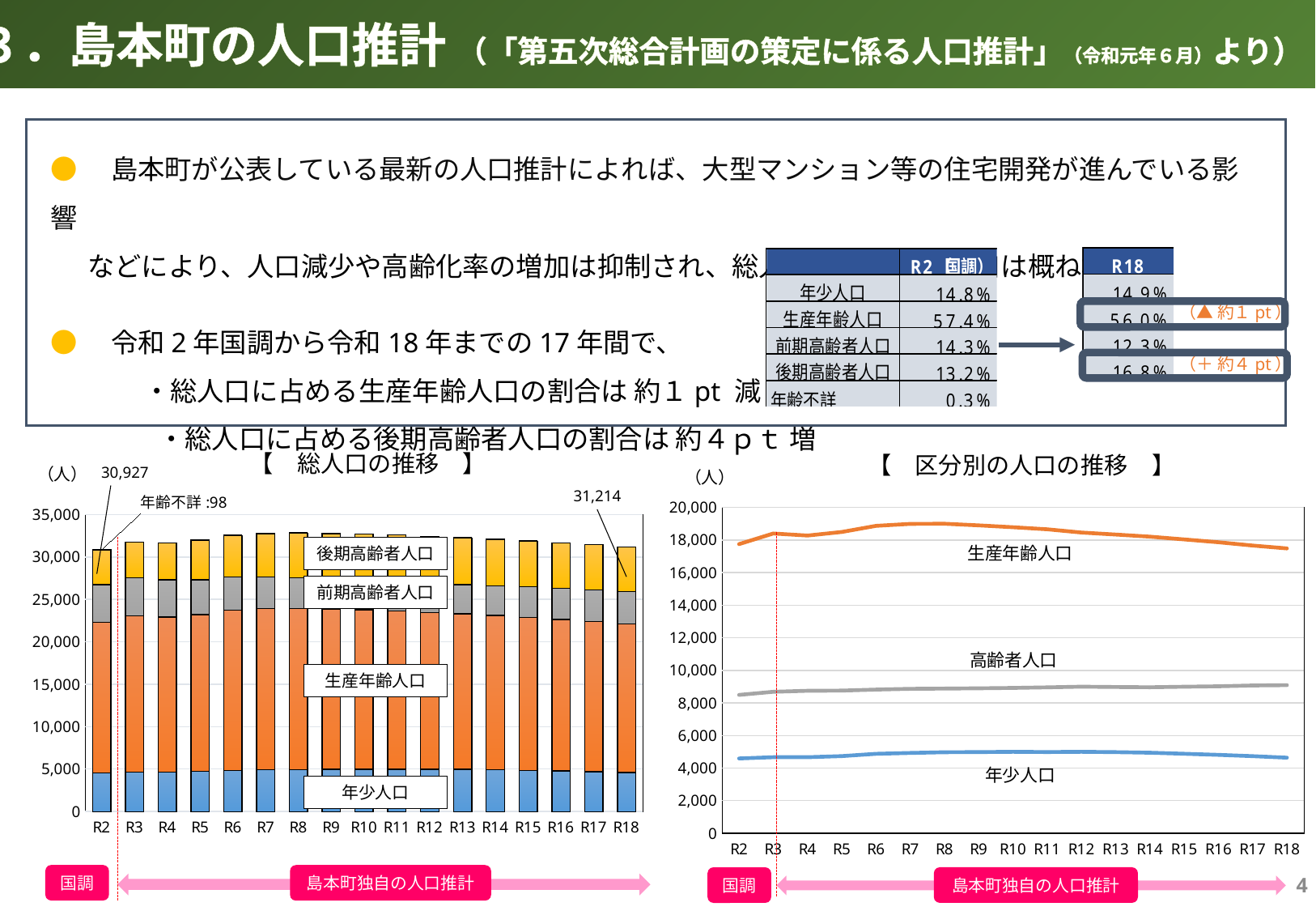
In the right chart 区分別の人口の推移, does the 生産年齢人口 line rise or fall from R8 to R18? fall In the left chart 総人口の推移, what is the total population labelled for R18? 31,214 In the right chart 区分別の人口の推移, which series has the highest values? 生産年齢人口 In the left chart 総人口の推移, what is the difference between the labelled totals for R18 and R2? 287 How many years (bars) are shown on the x axis of the left chart 総人口の推移? 17 What kind of chart is the right chart titled 区分別の人口の推移? line chart In the right chart 区分別の人口の推移, which series has the lowest values? 年少人口 In the left chart 総人口の推移, what is the total population labelled for R2? 30,927 How many population segments are stacked in each bar of the left chart 総人口の推移? 4 In the left chart 総人口の推移, which labelled total is larger, R2 or R18? R18 What kind of chart is the left chart titled 総人口の推移? bar chart In the right chart 区分別の人口の推移, is the value of 高齢者人口 at R18 greater or less than 10,000? less